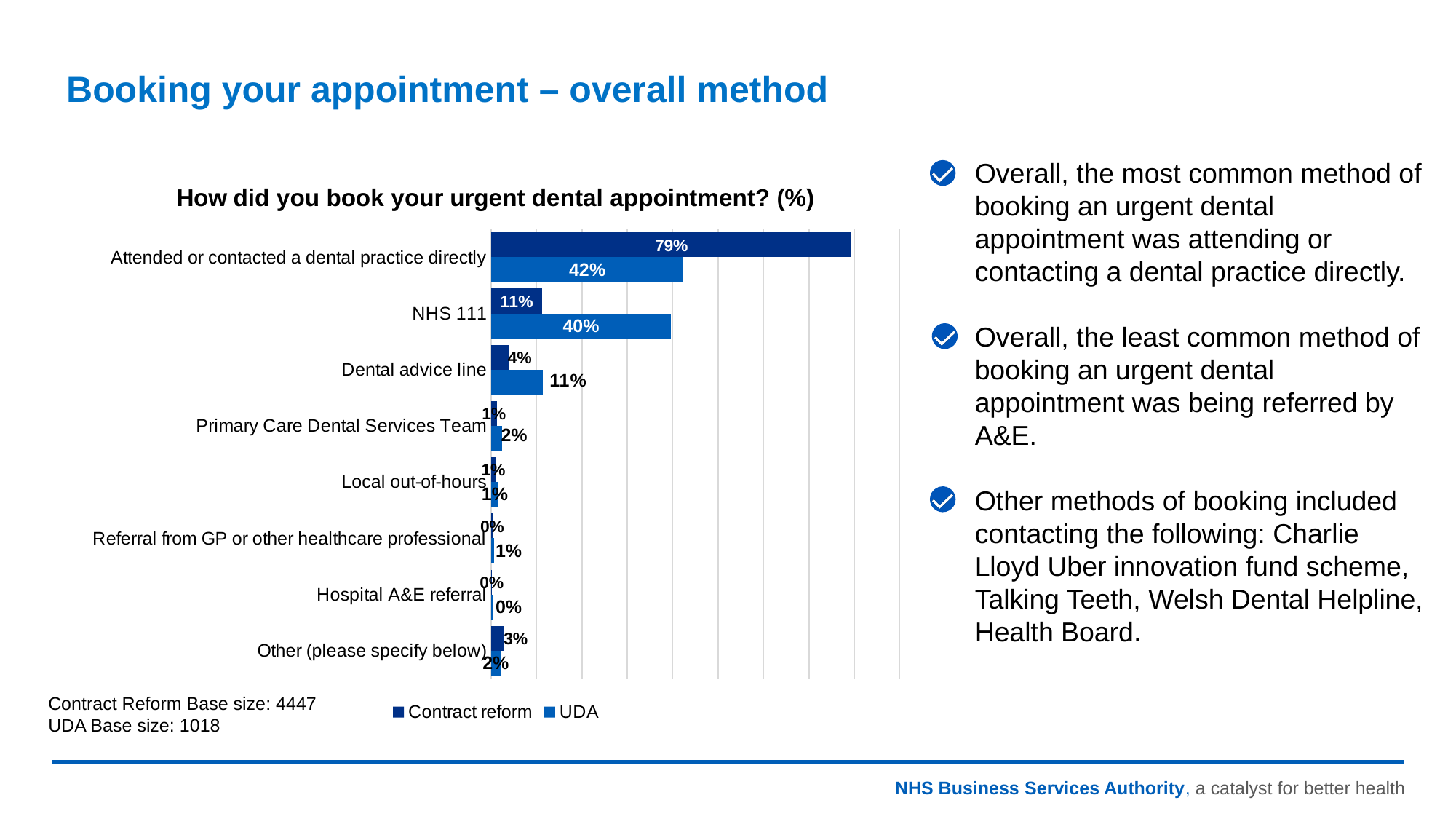
How many series does the legend list? 2 What is the UDA value for 'Dental advice line'? 11% Which category has the highest UDA value? Attended or contacted a dental practice directly How many categories are shown on the chart? 8 For 'Dental advice line', which series has the larger value, Contract reform or UDA? UDA What kind of chart is shown on the slide? Bar chart What is the difference between the UDA and Contract reform values for 'NHS 111'? 29% What is the UDA value for 'NHS 111'? 40% What is the difference between the Contract reform and UDA values for 'Attended or contacted a dental practice directly'? 37% Which category has the highest Contract reform value? Attended or contacted a dental practice directly What is the Contract reform value for 'Other (please specify below)'? 3% What is the Contract reform value for 'Attended or contacted a dental practice directly'? 79%